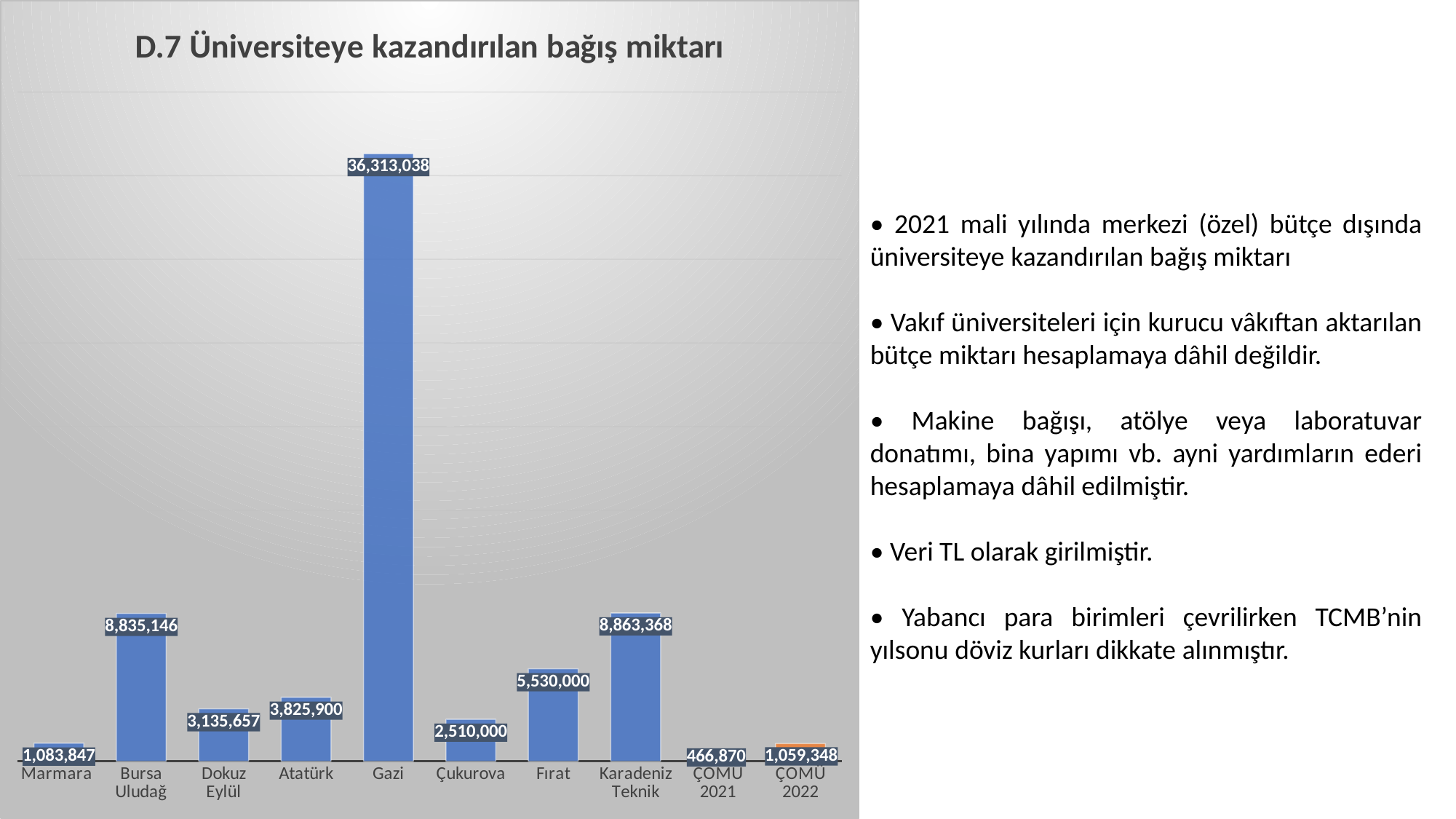
Which is larger, the value for Bursa Uludağ or the value for Karadeniz Teknik? Karadeniz Teknik What is the difference between the values for ÇOMÜ 2022 and ÇOMÜ 2021? 592,478 What is the value for Dokuz Eylül? 3,135,657 Which category has the lowest value? ÇOMÜ 2021 What kind of chart is this? Bar chart What is the title of the chart? D.7 Üniversiteye kazandırılan bağış miktarı What is the difference between the values for Fırat and Çukurova? 3,020,000 What is the value for Gazi? 36,313,038 What is the value for ÇOMÜ 2021? 466,870 Which category has the highest value? Gazi What is the value for Karadeniz Teknik? 8,863,368 How many categories are shown on the x axis? 10